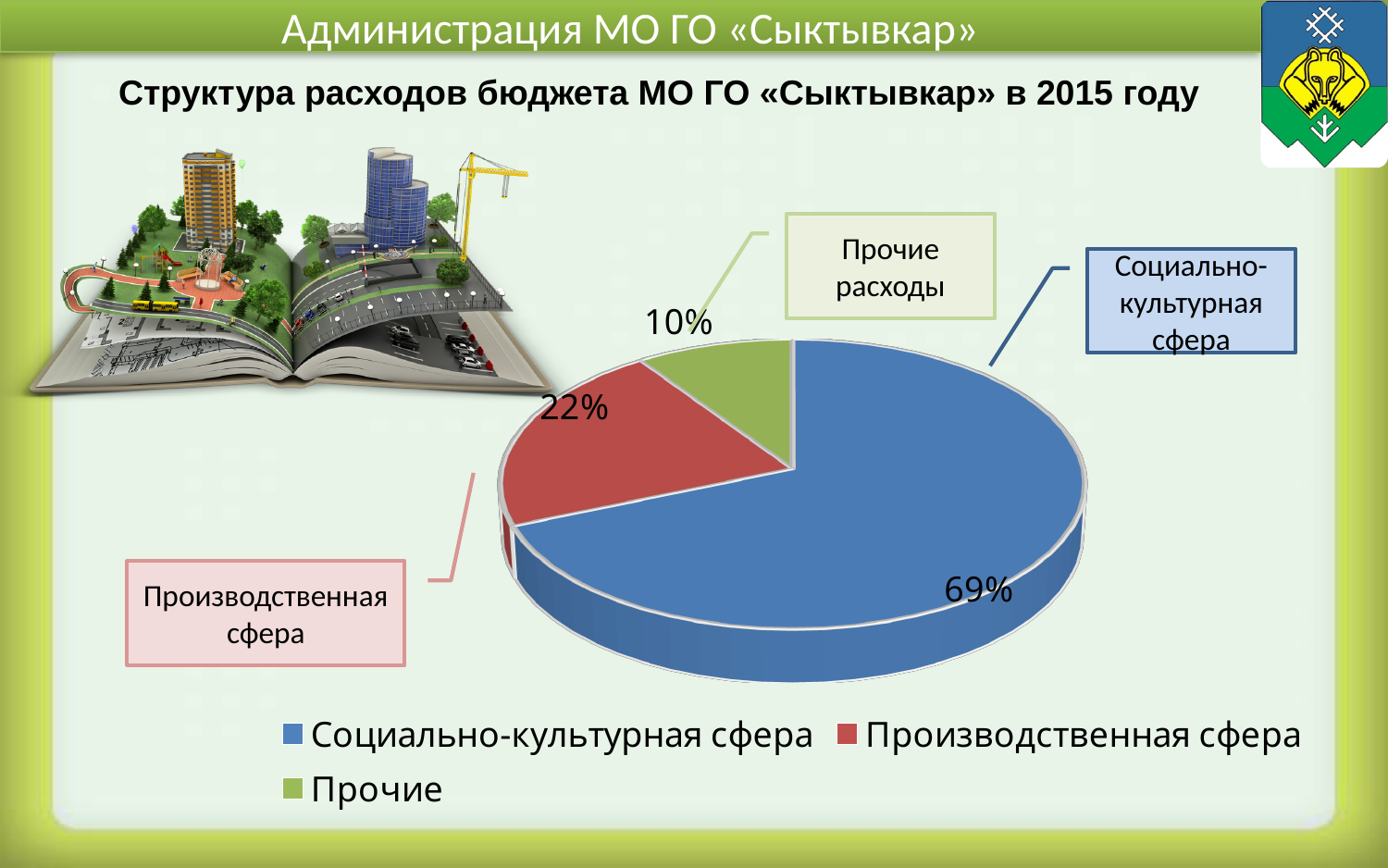
Which category has the largest slice of the pie? Социально-культурная сфера What is the difference in percentage points between Социально-культурная сфера and Производственная сфера? 47 What share of the pie does Производственная сфера have? 22% What is the difference in percentage points between Производственная сфера and Прочие? 12 What share of the pie does Прочие have? 10% How many entries does the legend list? 3 Which category has the smallest slice of the pie? Прочие How many slices does the pie chart have? 3 Which is larger, the slice for Производственная сфера or the slice for Прочие? Производственная сфера What kind of chart is shown on the slide? Pie chart What share of the pie does Социально-культурная сфера have? 69% What colour is the slice for Социально-культурная сфера? Blue